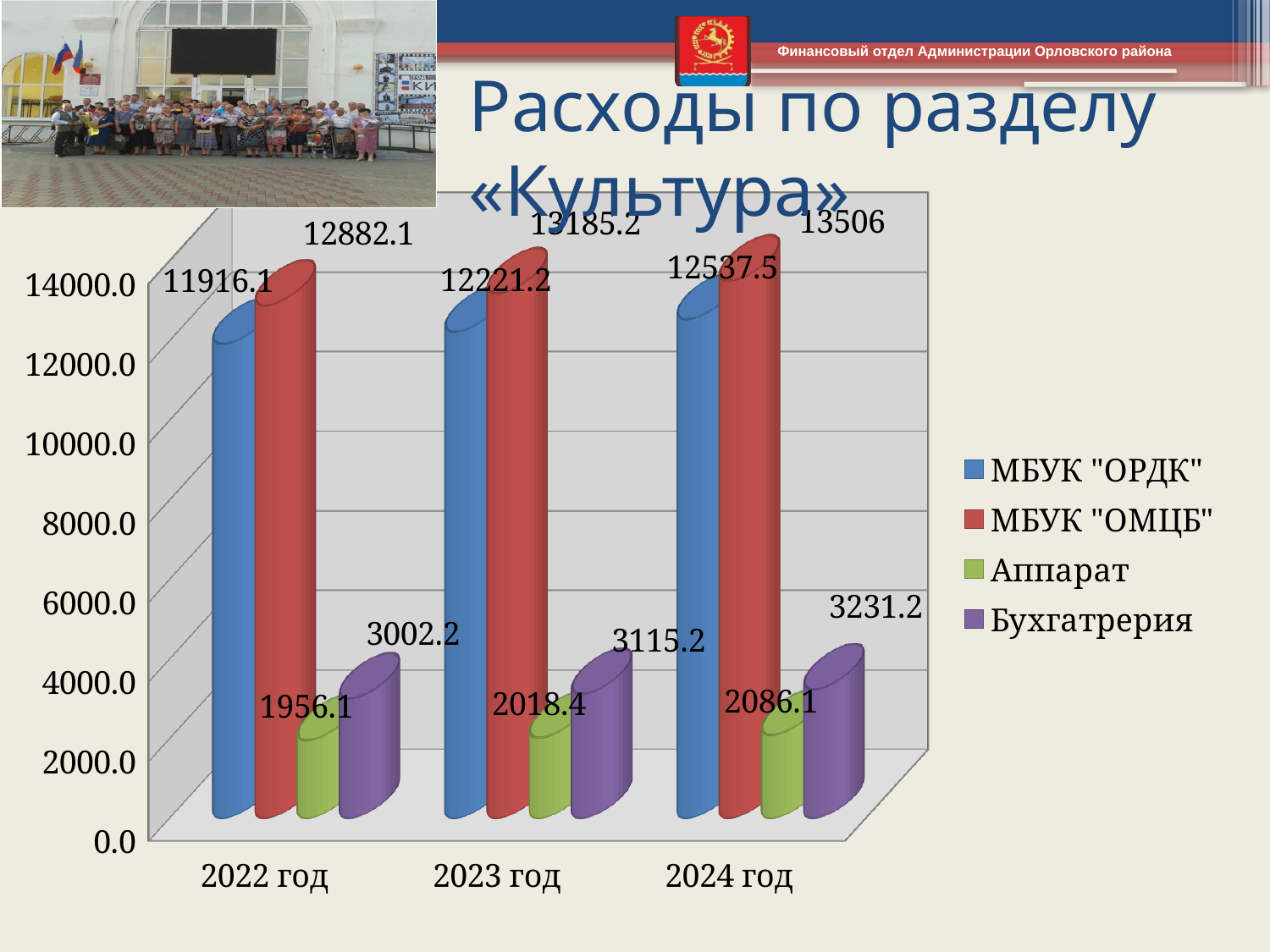
Which series has the highest value in 2023 год? МБУК "ОМЦБ" Which is larger: the Бухгатрерия value in 2023 год or the Аппарат value in 2023 год? Бухгатрерия What is the value for Бухгатрерия in 2022 год? 3002.2 How many series does the legend list? 4 What is the value for Аппарат in 2023 год? 2018.4 What is the value for МБУК "ОРДК" in 2022 год? 11916.1 What is the difference between the МБУК "ОМЦБ" and МБУК "ОРДК" values in 2024 год? 968.5 Do the values for МБУК "ОРДК" rise or fall from 2022 год to 2024 год? Rise What kind of chart is shown on the slide? Bar chart What is the value for МБУК "ОМЦБ" in 2024 год? 13506 How many year categories are shown on the x axis? 3 Which series has the lowest value in 2024 год? Аппарат